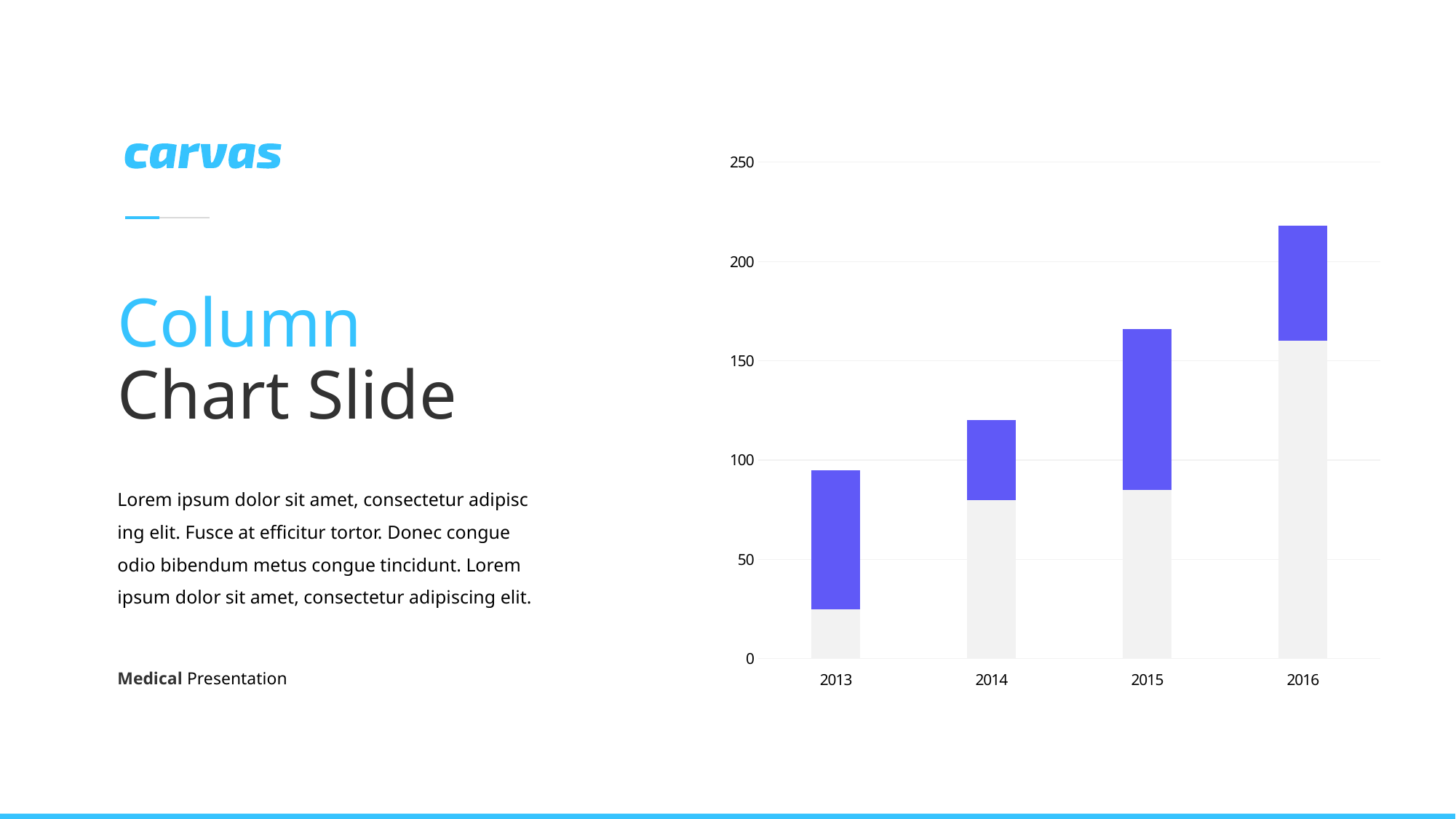
Which year has the tallest bar in the chart? 2016 Which bar is taller overall, 2014 or 2015? 2015 Is the total bar height for 2013 greater or less than 100? less Is the total bar height for 2016 greater or less than 200? greater How many categories are shown on the x axis of the chart? 4 Is the total bar height for 2015 greater or less than 150? greater Do the bar totals rise or fall from 2013 to 2016? rise What kind of chart is shown on the slide? bar chart Which year has the shortest bar in the chart? 2013 How many coloured segments does each bar in the chart have? 2